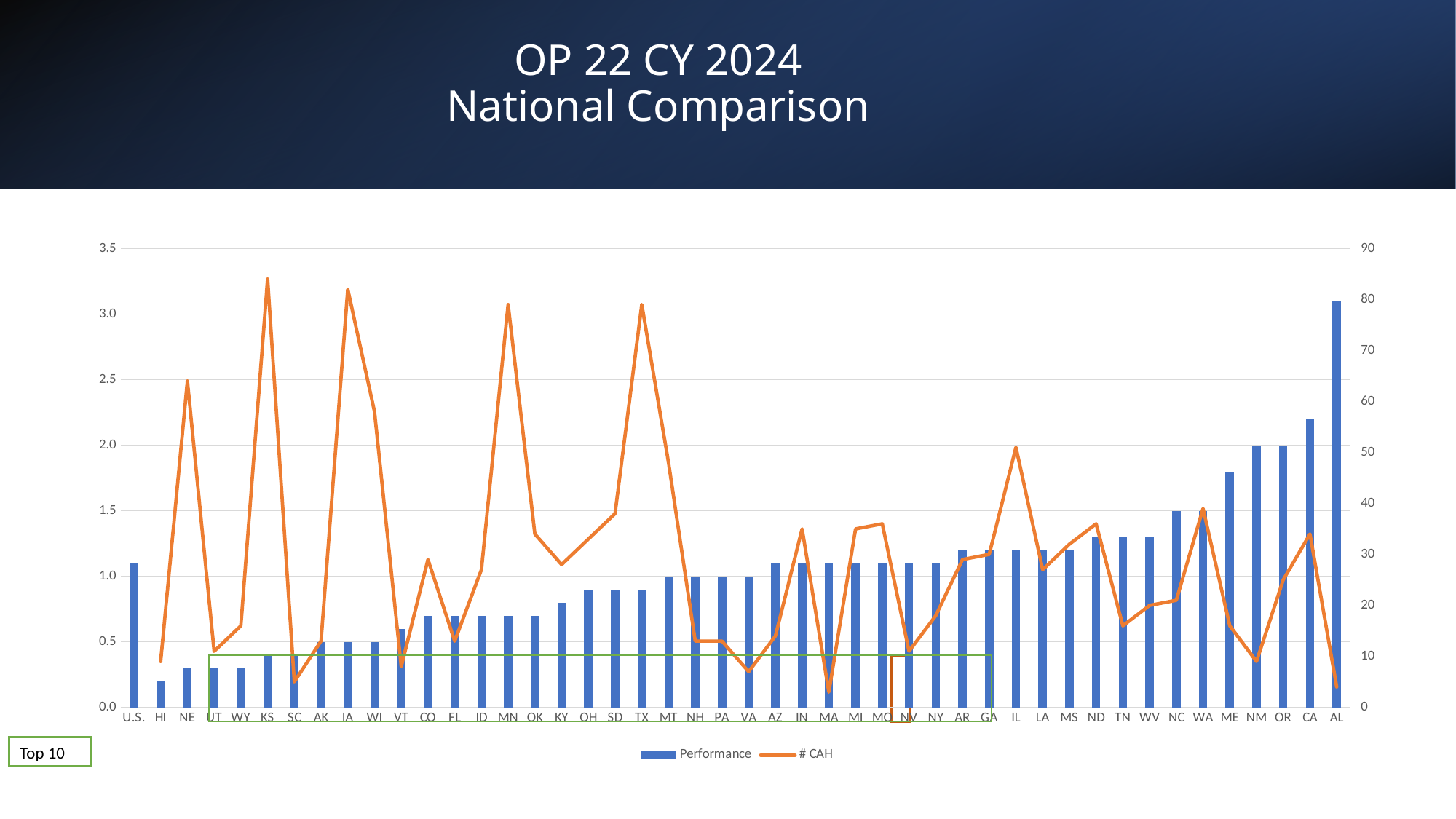
Which category has the lowest Performance bar? HI Which has the larger Performance bar, CA or OR? CA Is the Performance value for HI greater or less than 0.5? less Which category has the highest Performance bar? AL What are the two series named in the legend? Performance and # CAH Is the Performance value for AL greater or less than 2.5? greater Do the Performance bars generally rise or fall from left to right along the x axis? rise Is the # CAH value for KS greater or less than 80? greater What kind of chart is shown on the slide? A combination bar and line chart How many categories are plotted along the x axis? 46 Which category has the highest # CAH value on the line? KS How many series does the legend list? 2